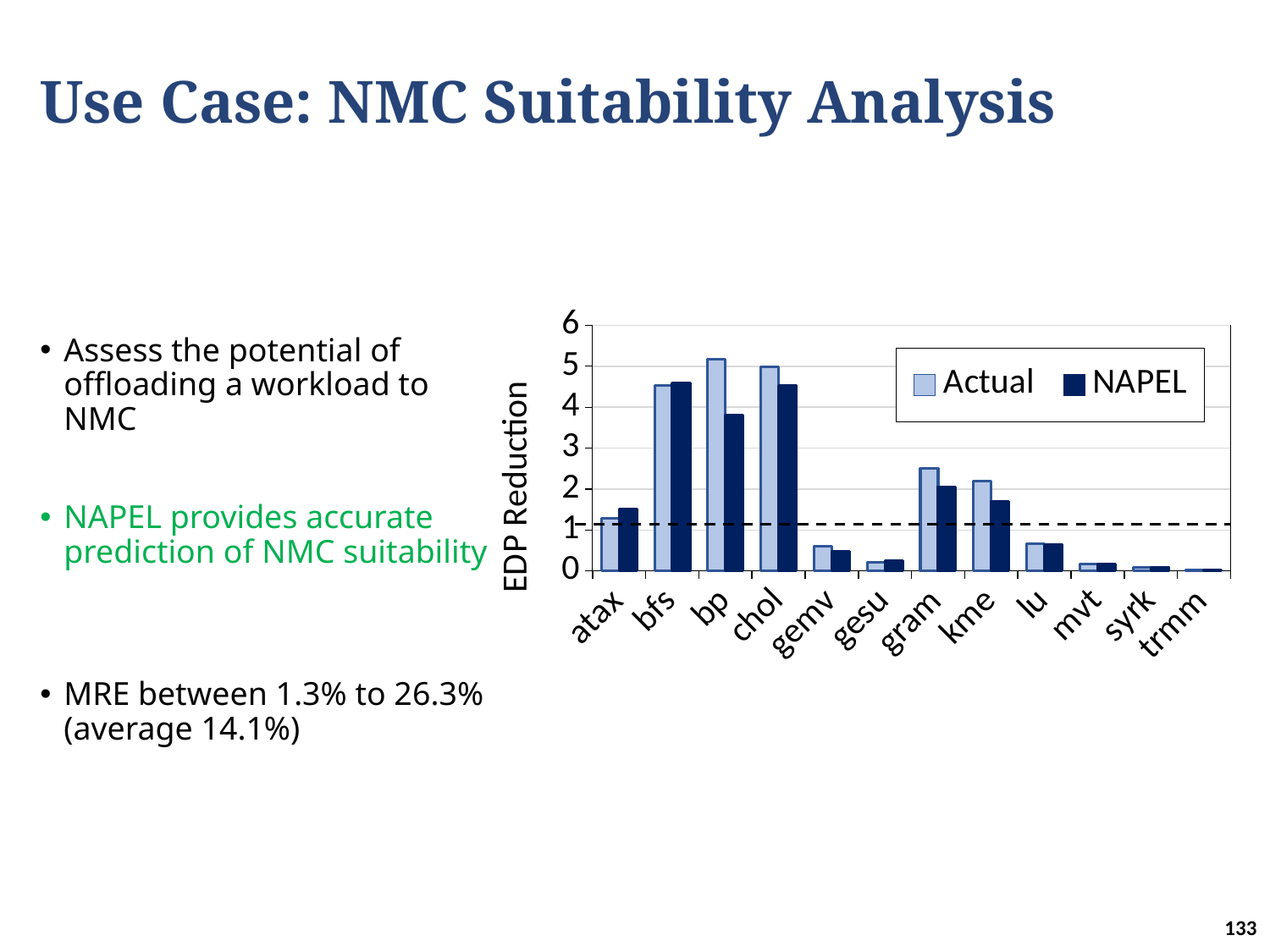
Is the NAPEL value for kme greater or less than 2? less Is the Actual value for gram greater or less than 2? greater How many workload categories are shown on the x axis of the chart? 12 For atax, which is larger: the Actual value or the NAPEL value? NAPEL Is the NAPEL value for bp greater or less than 4? less What kind of chart is shown on the slide? bar chart Which category has the highest Actual EDP Reduction? bp For bp, which is larger: the Actual value or the NAPEL value? Actual What is the label of the vertical axis of the chart? EDP Reduction Which two series are listed in the chart legend? Actual and NAPEL How many series does the chart legend list? 2